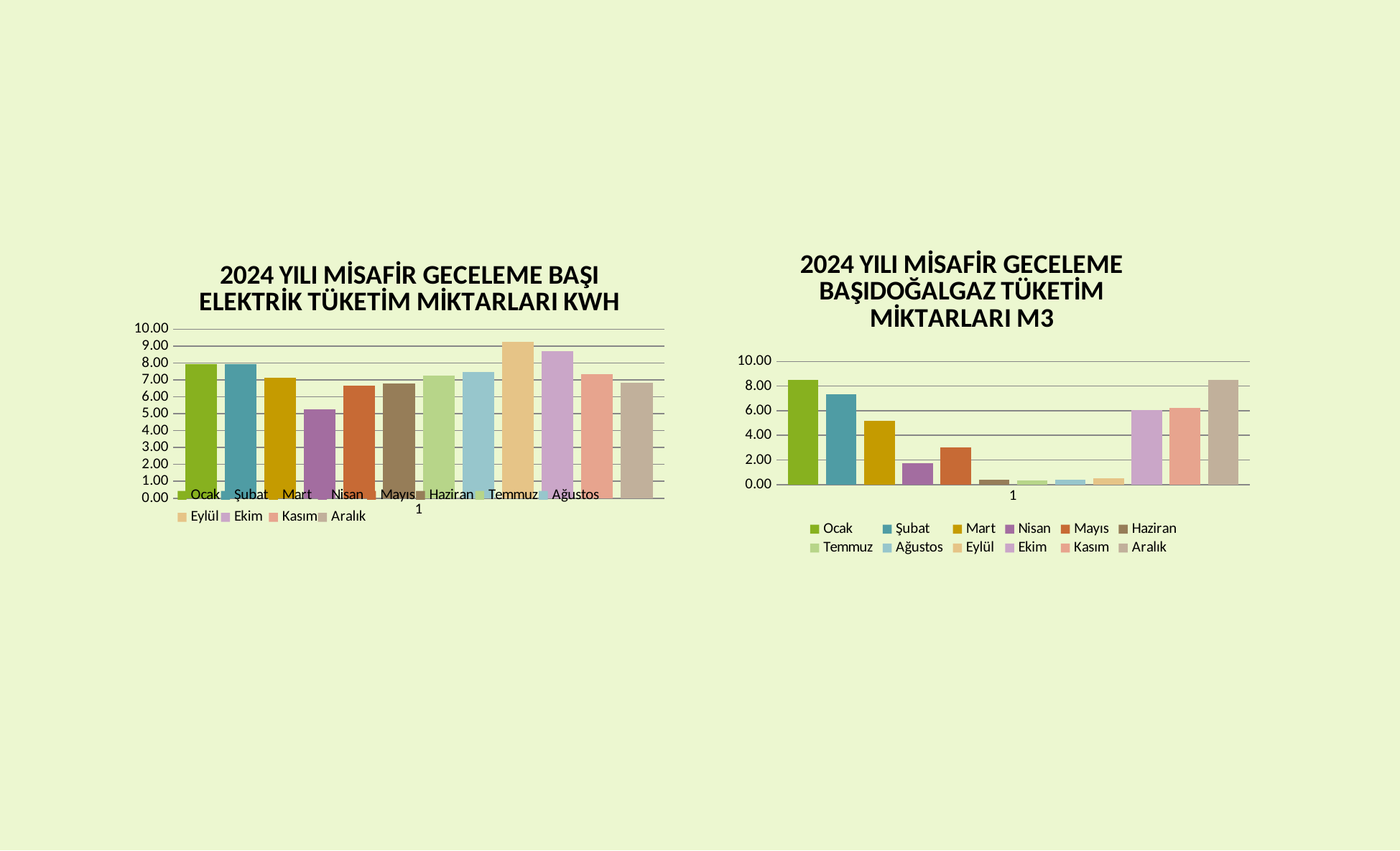
In the right chart (natural gas, M3), which is larger, the value for Ocak or the value for Mart? Ocak What is the title of the right chart? 2024 YILI MİSAFİR GECELEME BAŞIDOĞALGAZ TÜKETİM MİKTARLARI M3 In the right chart (natural gas, M3), is the value for Ocak greater or less than 8.00? greater In the left chart (electricity, KWH), is the value for Eylül greater or less than 9.00? greater In the left chart (electricity, KWH), which month has the highest bar? Eylül In the left chart (electricity, KWH), is the value for Nisan greater or less than 6.00? less How many series does the legend of the right chart (natural gas, M3) list? 12 In the left chart (electricity, KWH), which month has the lowest bar? Nisan How many series does the legend of the left chart (electricity, KWH) list? 12 In the right chart (natural gas, M3), which is larger, the value for Mayıs or the value for Nisan? Mayıs What kind of chart is the left chart titled '2024 YILI MİSAFİR GECELEME BAŞI ELEKTRİK TÜKETİM MİKTARLARI KWH'? bar chart